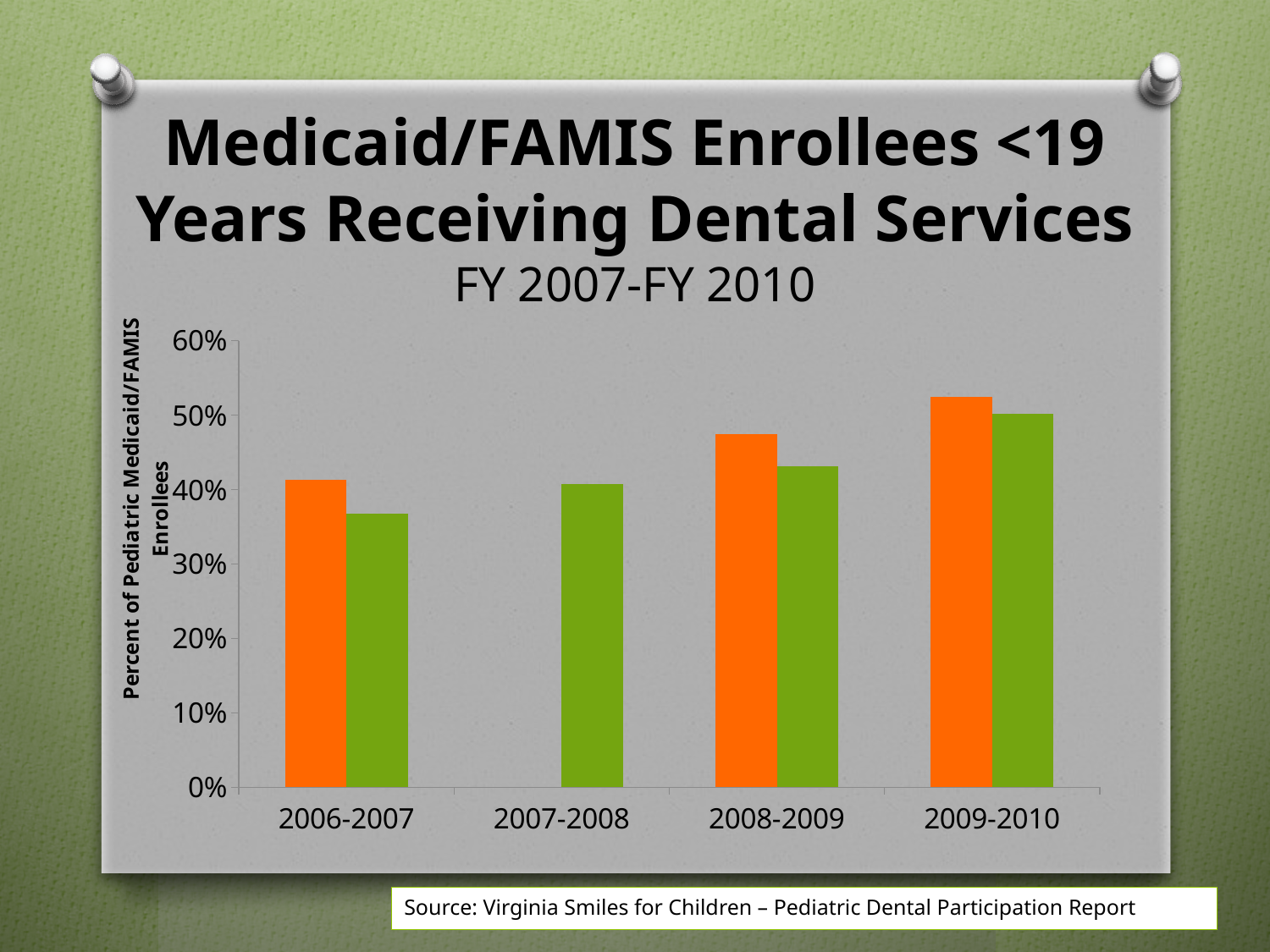
Is the orange bar for 2008-2009 greater or less than 50%? less For 2006-2007, which bar is taller, the orange or the green? orange Do the green bars rise or fall from 2006-2007 to 2009-2010? rise Which fiscal-year category has only one bar (no orange bar)? 2007-2008 In which fiscal-year category is the orange bar highest? 2009-2010 Is the green bar for 2006-2007 greater or less than 40%? less How many fiscal-year categories are shown on the x axis? 4 What is the label on the vertical axis? Percent of Pediatric Medicaid/FAMIS Enrollees Is the green bar for 2008-2009 greater or less than 40%? greater What kind of chart is shown on the slide? bar chart In which fiscal-year category is the green bar lowest? 2006-2007